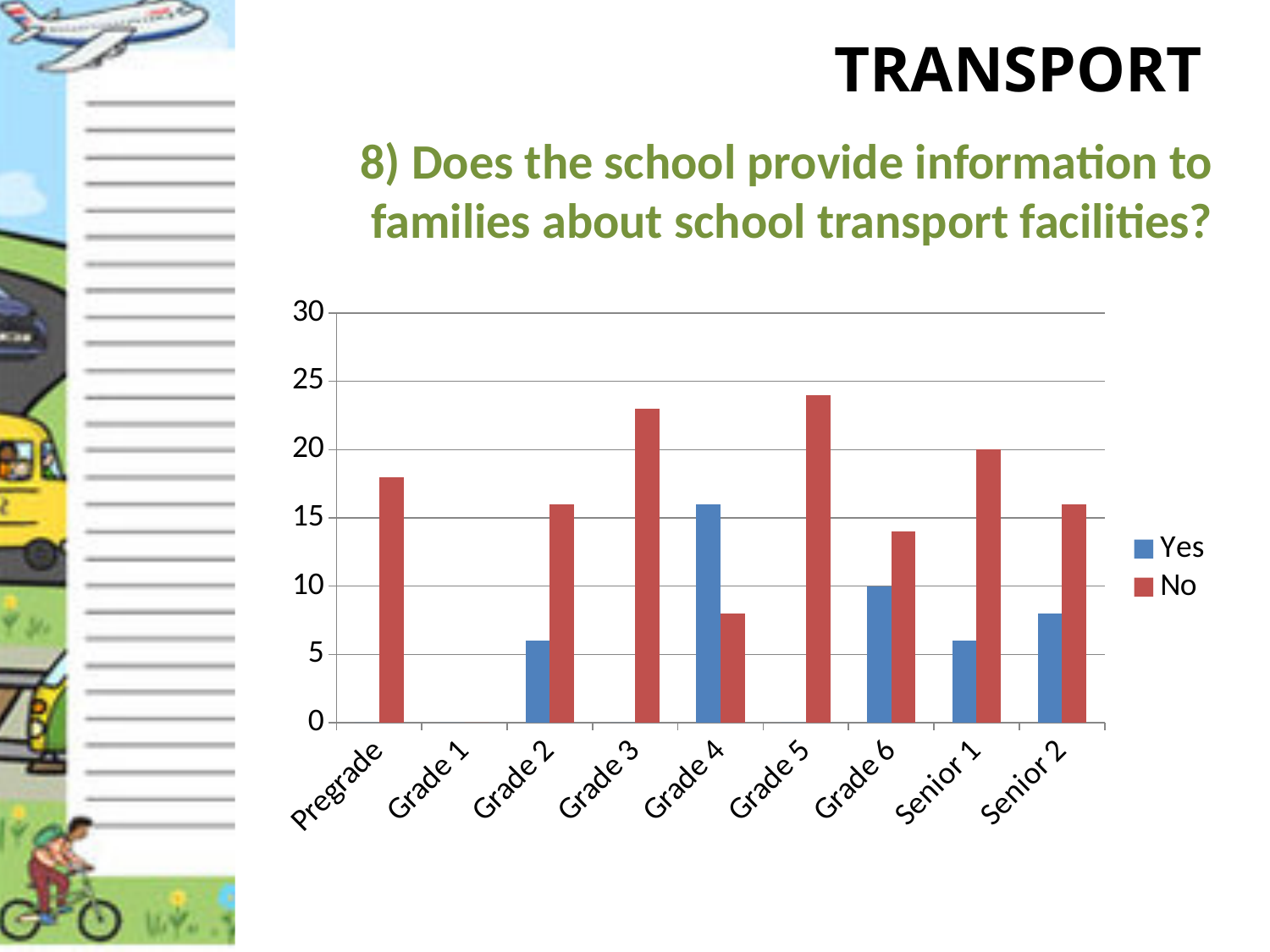
Is the No value for Grade 4 greater or less than 10? less For Grade 4, which is larger, the Yes value or the No value? Yes How many grade categories are shown on the x axis? 9 Is the Yes value for Grade 2 greater or less than 10? less Is the No value for Grade 3 greater or less than 20? greater For Senior 1, which is larger, the Yes value or the No value? No How many series does the legend list? 2 Which category has the highest Yes value? Grade 4 What kind of chart is shown on the slide? bar chart What is the No value for Senior 1? 20 What are the two entries in the legend? Yes and No